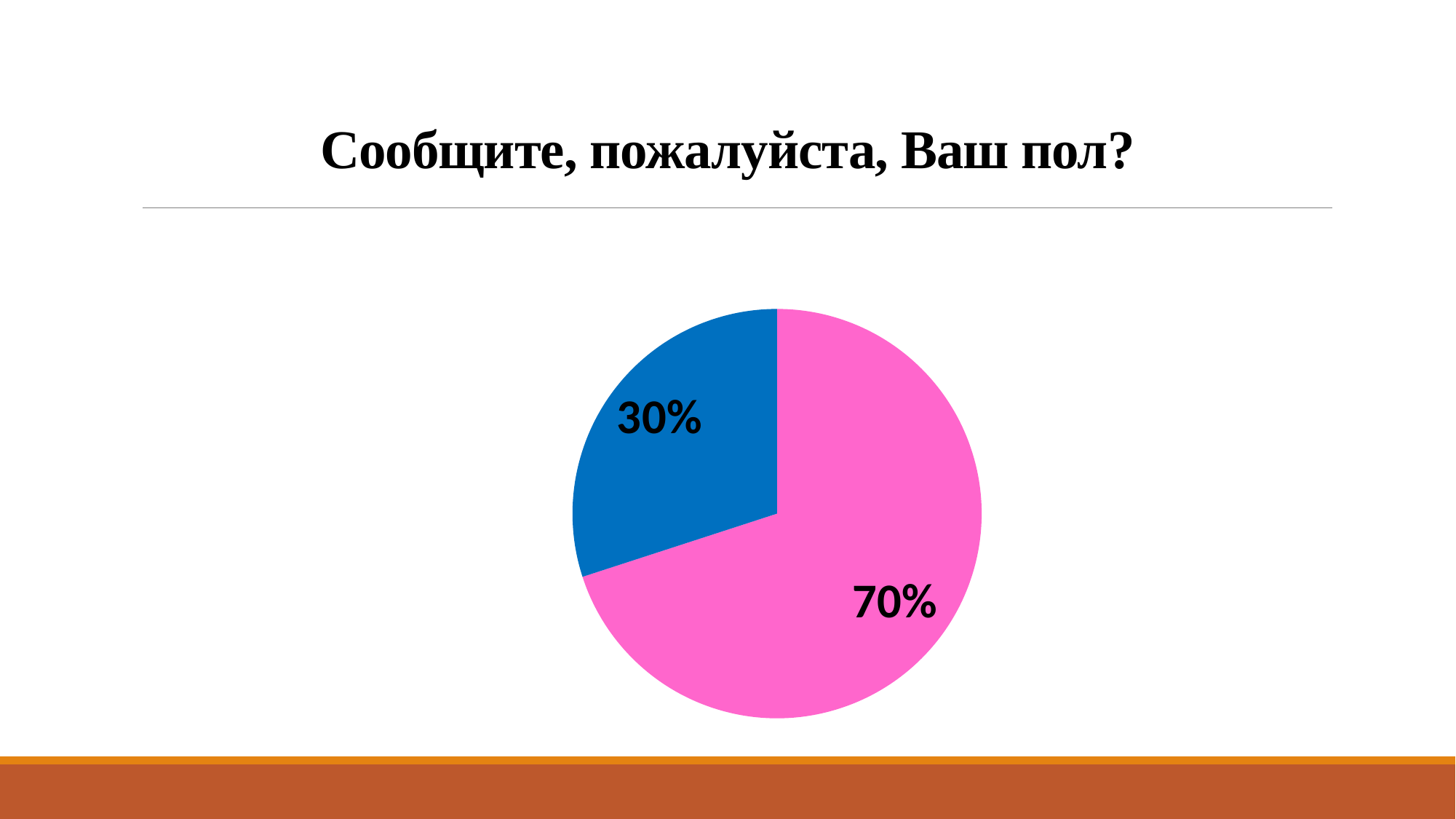
Which is larger, the blue slice or the pink slice? the pink slice How many slices does the pie chart have? 2 What share of the pie does the blue slice represent? 30% By how many percentage points does the pink slice exceed the blue slice? 40 percentage points What share of the pie does the pink slice represent? 70% Which slice of the pie chart is the largest? the pink slice (70%) Which slice of the pie chart is the smallest? the blue slice (30%) Does the pie chart include a legend? No Is the share of the blue slice greater or less than 50%? less What do the two slice percentages add up to? 100% What kind of chart is shown on the slide? pie chart What is the title of the slide above the pie chart? Сообщите, пожалуйста, Ваш пол?